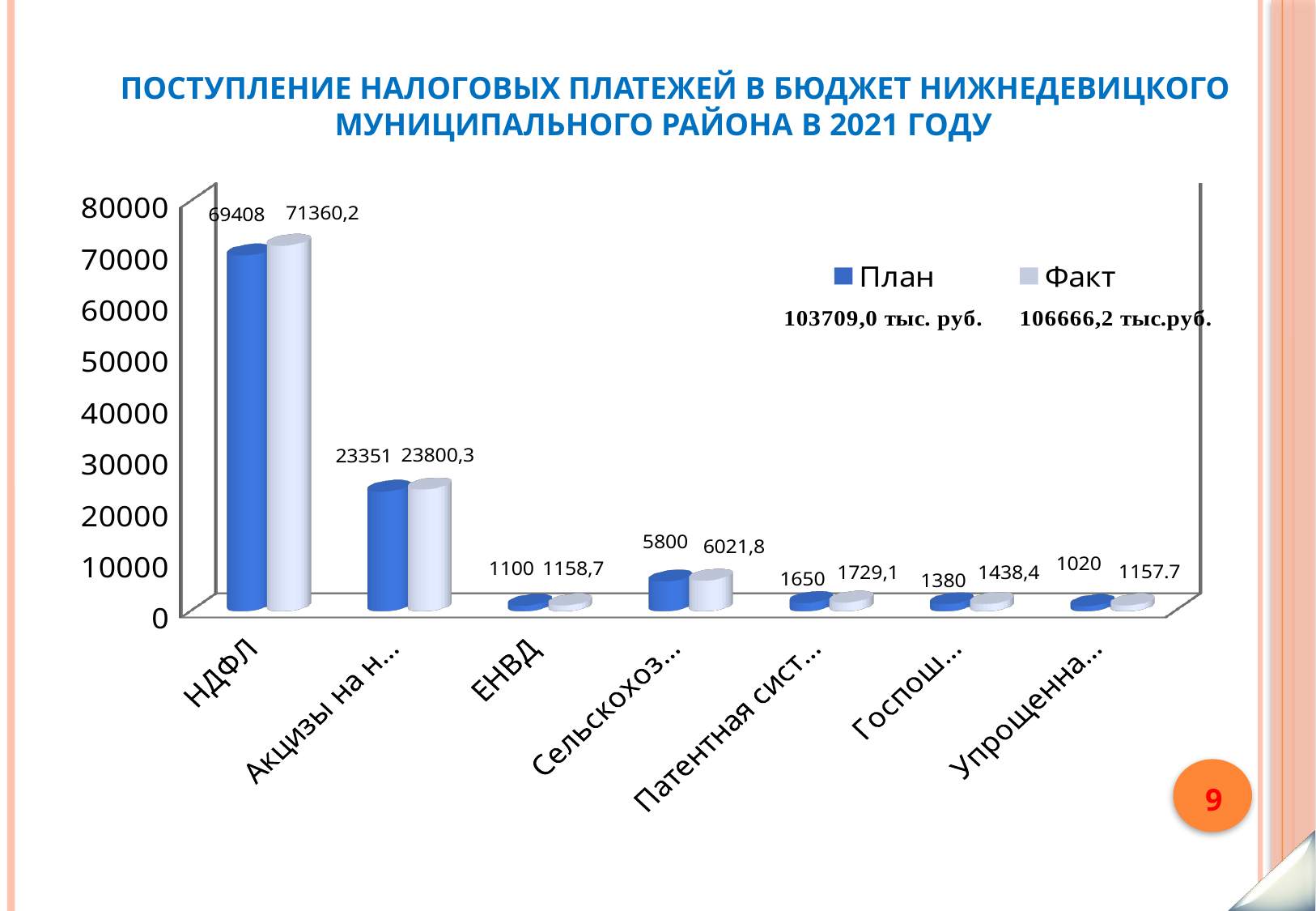
What is the План (plan) value for НДФЛ? 69408 What is the difference between the Факт and План values for НДФЛ? 1952,2 What is the difference between the Факт and План values for ЕНВД? 58,7 Which category has the highest Факт value? НДФЛ What kind of chart is shown on the slide? Bar chart What total is printed under the Факт legend entry? 106666,2 тыс.руб. What is the Факт (actual) value for НДФЛ? 71360,2 What is the Факт value for ЕНВД? 1158,7 How many series does the legend list? 2 How many categories are shown on the x axis? 7 For НДФЛ, which is larger: the План value or the Факт value? Факт What is the План value for ЕНВД? 1100